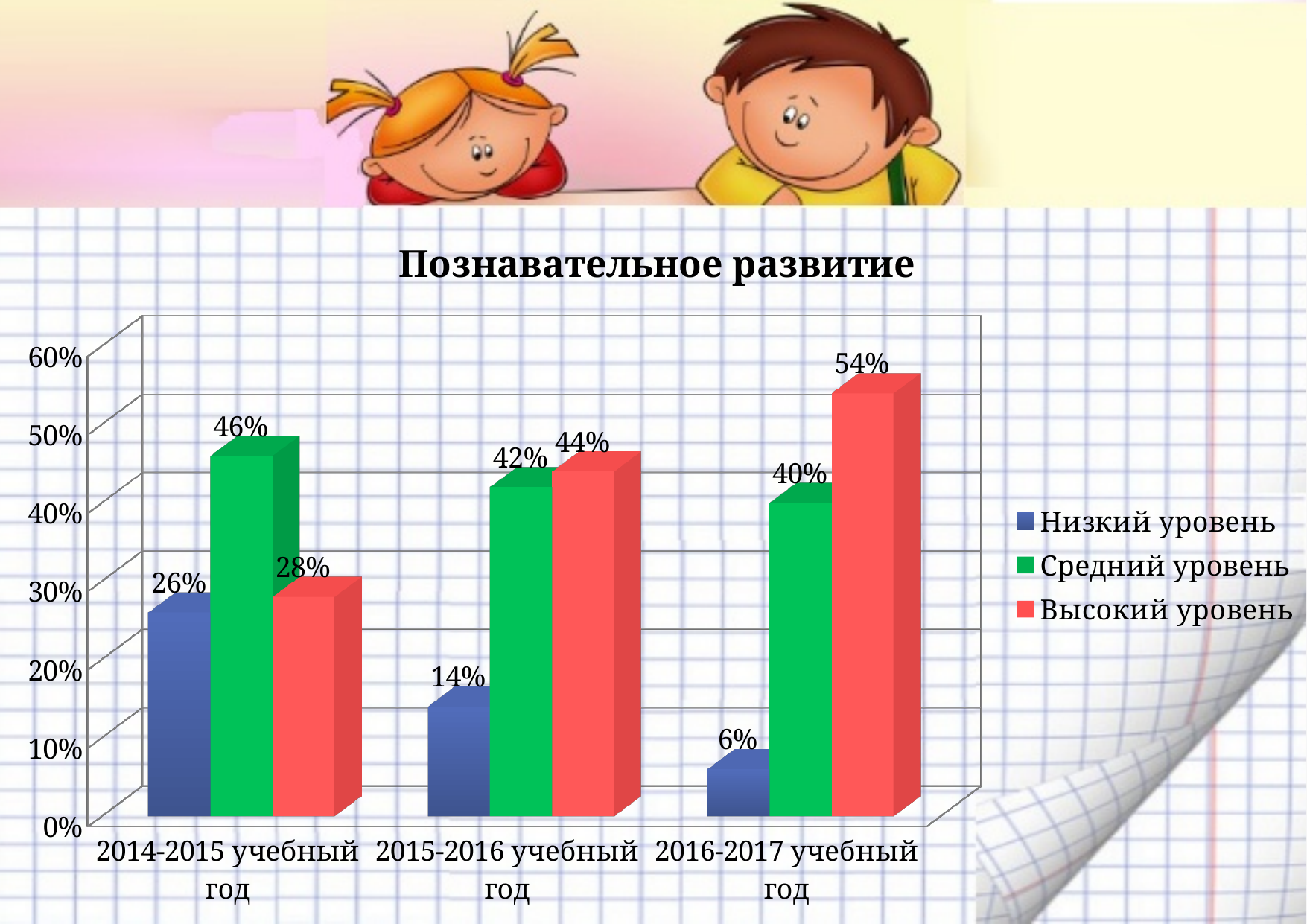
What is the value for Средний уровень in 2015-2016 учебный год? 42% What kind of chart is shown on the slide? Bar chart What is the difference between Высокий уровень in 2016-2017 учебный год and in 2014-2015 учебный год? 26% Which school year has the lowest value for Низкий уровень? 2016-2017 учебный год Which is larger in 2015-2016 учебный год: Средний уровень or Высокий уровень? Высокий уровень How many series does the legend list? 3 Does the value for Низкий уровень rise or fall across the school years? Fall How many school years are shown on the x axis? 3 What is the value for Высокий уровень in 2016-2017 учебный год? 54% Which school year has the highest value for Высокий уровень? 2016-2017 учебный год What is the value for Низкий уровень in 2014-2015 учебный год? 26% What is the title of the chart? Познавательное развитие